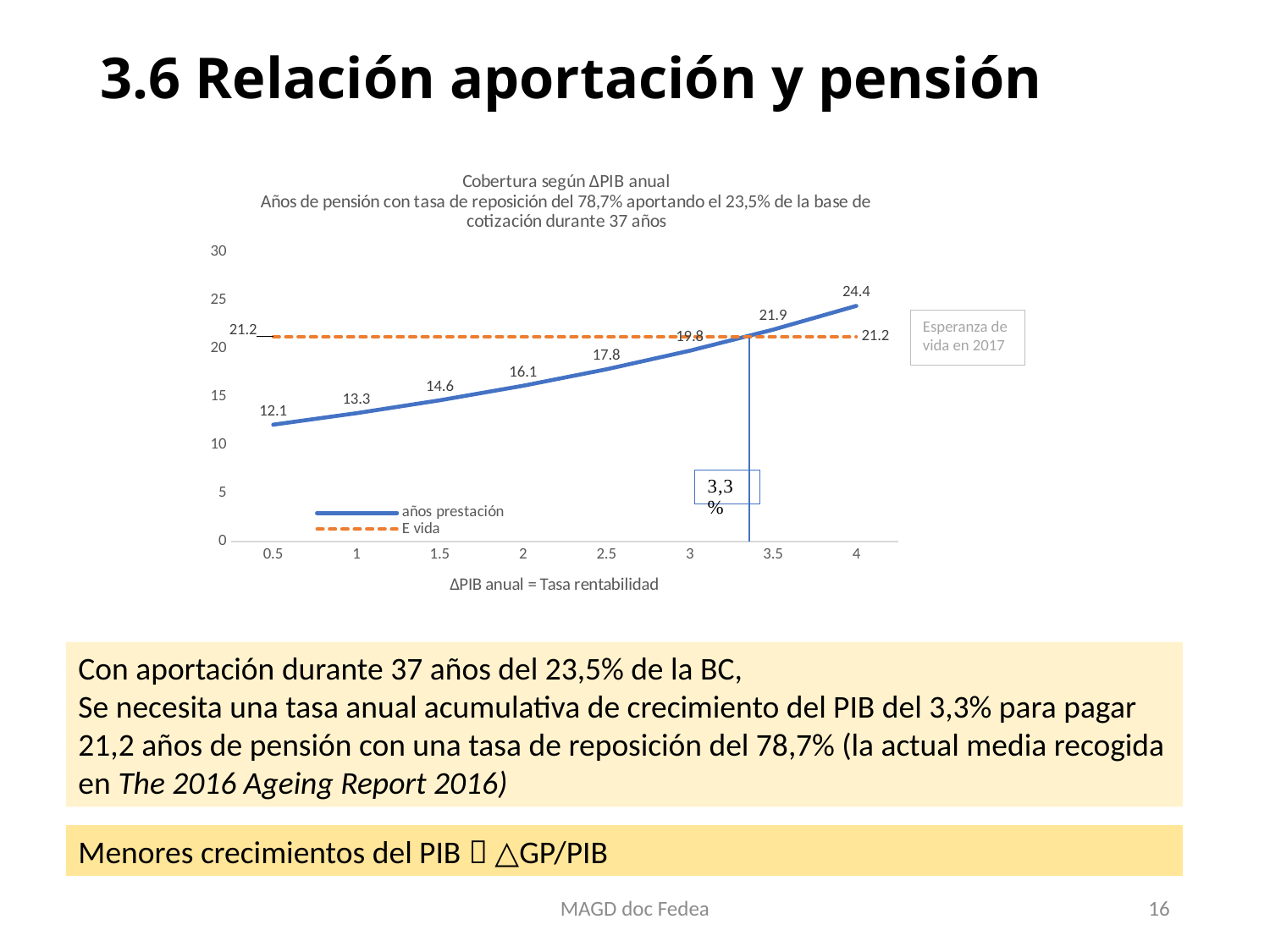
How many series does the legend list? 2 How many data points are plotted for 'años prestación'? 8 What is the value of the 'E vida' series? 21.2 What is the value of 'años prestación' at ΔPIB anual = 2? 16.1 What type of chart is shown on the slide? line chart At which ΔPIB anual value is 'años prestación' highest? 4 What is the value of 'años prestación' at ΔPIB anual = 4? 24.4 At which ΔPIB anual value is 'años prestación' lowest? 0.5 Does 'años prestación' rise or fall as ΔPIB anual increases? rise What is the value of 'años prestación' at ΔPIB anual = 0.5? 12.1 Which is larger: 'años prestación' at ΔPIB anual = 3 or the 'E vida' value? E vida (21.2) What is the difference between 'años prestación' at ΔPIB anual = 4 and at ΔPIB anual = 0.5? 12.3